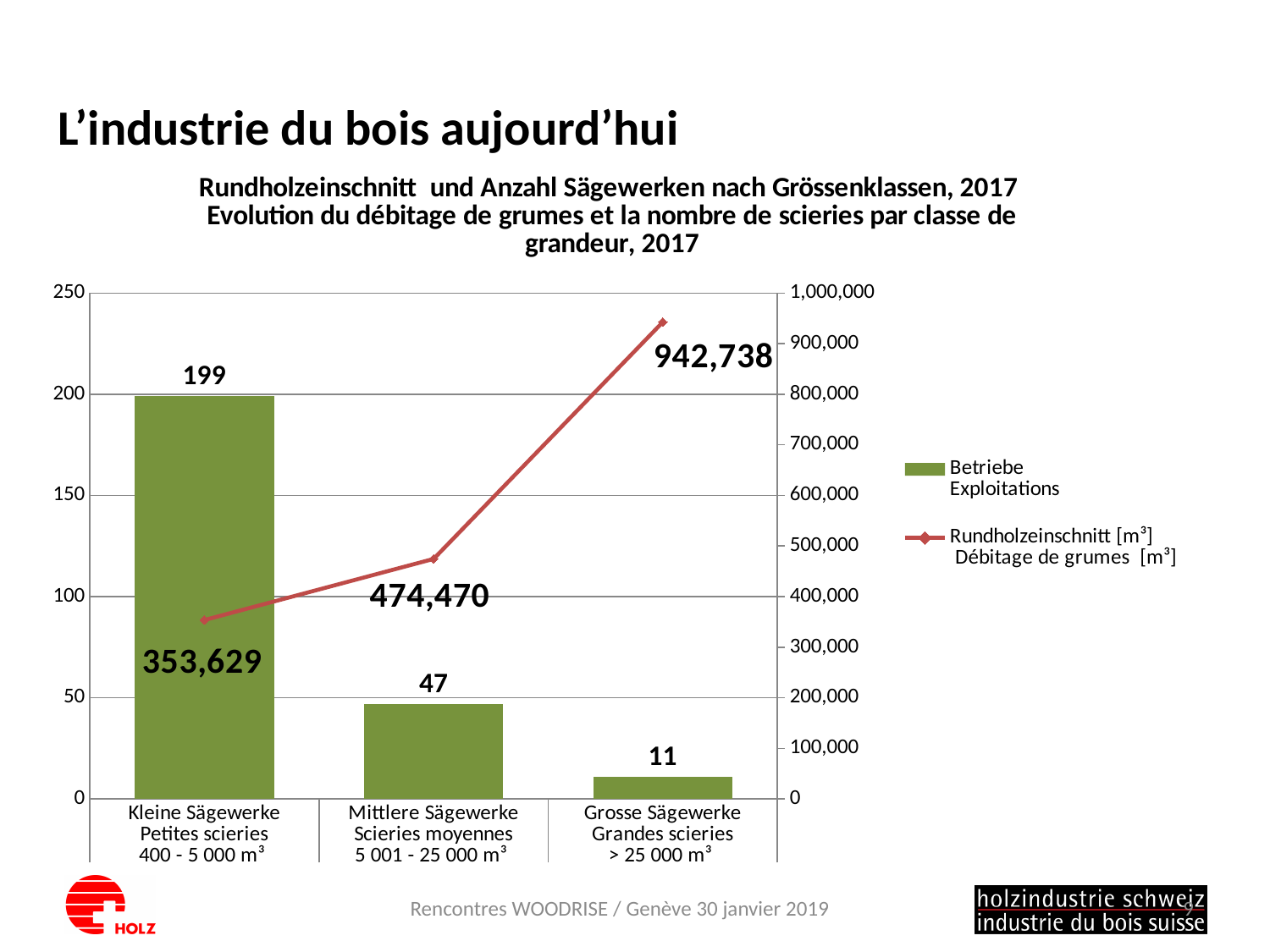
Which size class has the lowest Rundholzeinschnitt [m³]? Kleine Sägewerke What is the Rundholzeinschnitt [m³] value for Grosse Sägewerke (Grandes scieries)? 942,738 How many series does the legend list? 2 How many Betriebe / Exploitations are shown for Kleine Sägewerke (Petites scieries)? 199 What is the total number of Betriebe / Exploitations across all three size classes? 257 How many size classes (categories) are shown on the x axis? 3 What is the Rundholzeinschnitt [m³] value for Mittlere Sägewerke (Scieries moyennes)? 474,470 Does the Rundholzeinschnitt [m³] line rise or fall from Kleine Sägewerke to Grosse Sägewerke? rise What is the difference in Betriebe / Exploitations between Kleine Sägewerke and Mittlere Sägewerke? 152 What is the difference in Rundholzeinschnitt [m³] between Grosse Sägewerke and Mittlere Sägewerke? 468,268 Which has more Betriebe / Exploitations: Mittlere Sägewerke or Grosse Sägewerke? Mittlere Sägewerke Which size class has the highest number of Betriebe / Exploitations? Kleine Sägewerke